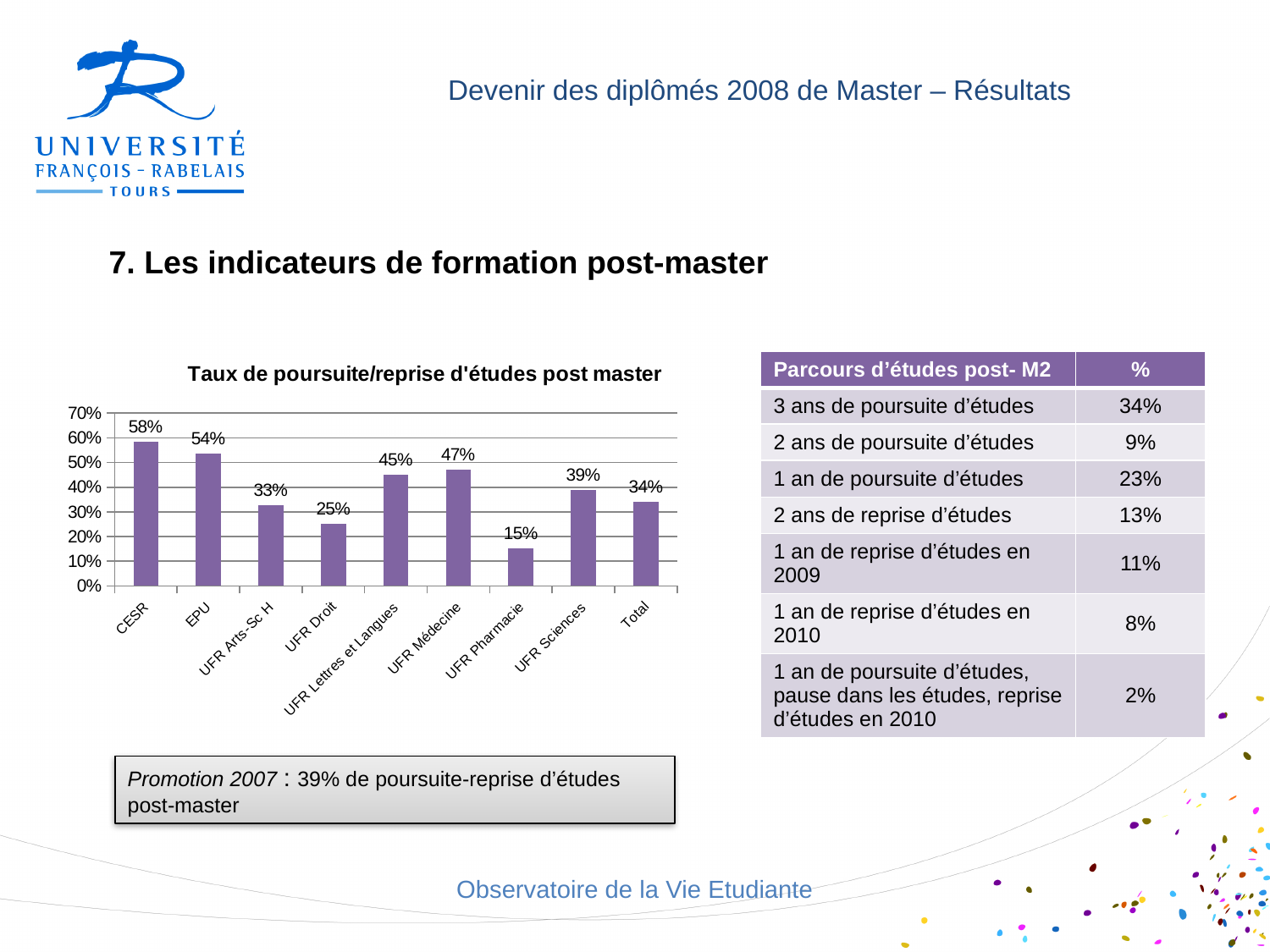
What is the difference between the values for UFR Sciences and UFR Droit? 14% What is the value for UFR Médecine in the chart? 47% How many categories are shown on the x axis of the chart? 9 Which is larger, the value for UFR Lettres et Langues or the value for UFR Arts-Sc H? UFR Lettres et Langues What is the value for UFR Pharmacie in the chart? 15% What kind of chart is shown on the slide? Bar chart What is the difference between the values for CESR and EPU? 4% What is the value for Total in the chart? 34% What is the title of the chart? Taux de poursuite/reprise d'études post master Which category has the highest value in the chart? CESR Which category has the lowest value in the chart? UFR Pharmacie What is the value for CESR in the chart? 58%